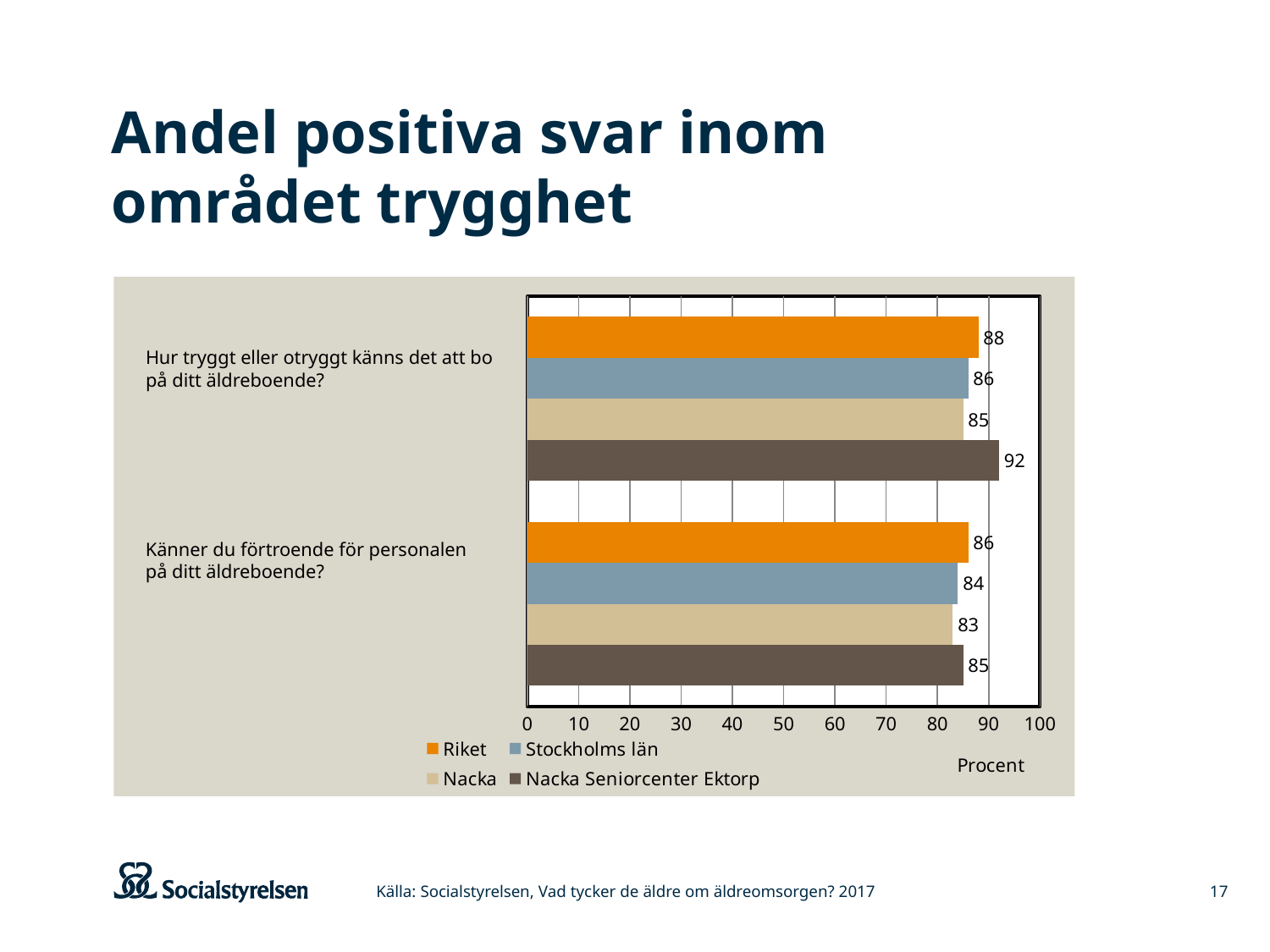
Which series has the highest value for the question "Hur tryggt eller otryggt känns det att bo på ditt äldreboende?"? Nacka Seniorcenter Ektorp Is the value for Nacka Seniorcenter Ektorp for the question "Hur tryggt eller otryggt känns det att bo på ditt äldreboende?" greater or less than 90? greater Which series has the lowest value for the question "Känner du förtroende för personalen på ditt äldreboende?"? Nacka What kind of chart is shown on the slide? Bar chart What is the value for Nacka Seniorcenter Ektorp for the question "Hur tryggt eller otryggt känns det att bo på ditt äldreboende?"? 92 What is the label of the x axis? Procent What is the value for Stockholms län for the question "Hur tryggt eller otryggt känns det att bo på ditt äldreboende?"? 86 What is the value for Nacka for the question "Känner du förtroende för personalen på ditt äldreboende?"? 83 What is the value for Riket for the question "Känner du förtroende för personalen på ditt äldreboende?"? 86 Which is larger for the question "Känner du förtroende för personalen på ditt äldreboende?": Riket or Nacka? Riket How many series does the legend list? 4 What is the difference between Nacka Seniorcenter Ektorp and Nacka for the question "Hur tryggt eller otryggt känns det att bo på ditt äldreboende?"? 7